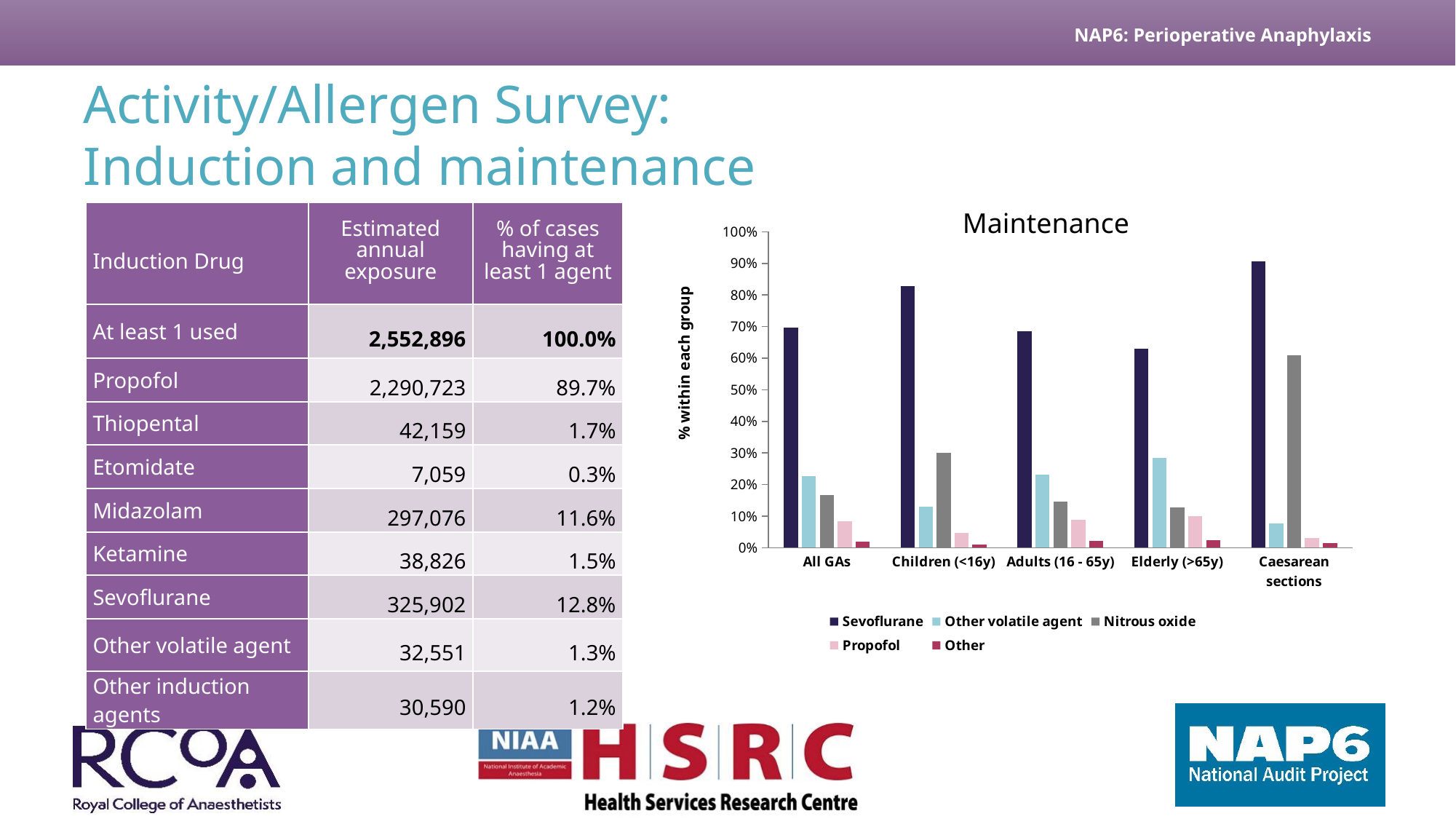
In the Maintenance chart, is the Other volatile agent value for Elderly (>65y) greater or less than 20%? greater How many patient groups are shown on the x axis of the Maintenance chart? 5 What kind of chart is the Maintenance chart? bar chart In the Maintenance chart, for Caesarean sections, which is larger: Nitrous oxide or Other volatile agent? Nitrous oxide In the Maintenance chart, is the Sevoflurane value for Children (<16y) greater or less than 80%? greater In the Maintenance chart, which group has the lowest Sevoflurane value? Elderly (>65y) In the Maintenance chart, for Elderly (>65y), which is larger: Other volatile agent or Nitrous oxide? Other volatile agent How many series does the legend of the Maintenance chart list? 5 In the Maintenance chart, which group has the highest Nitrous oxide value? Caesarean sections In the Maintenance chart, which group has the highest Sevoflurane value? Caesarean sections In the Maintenance chart, is the Nitrous oxide value for Caesarean sections greater or less than 50%? greater What is the y-axis title of the Maintenance chart? % within each group